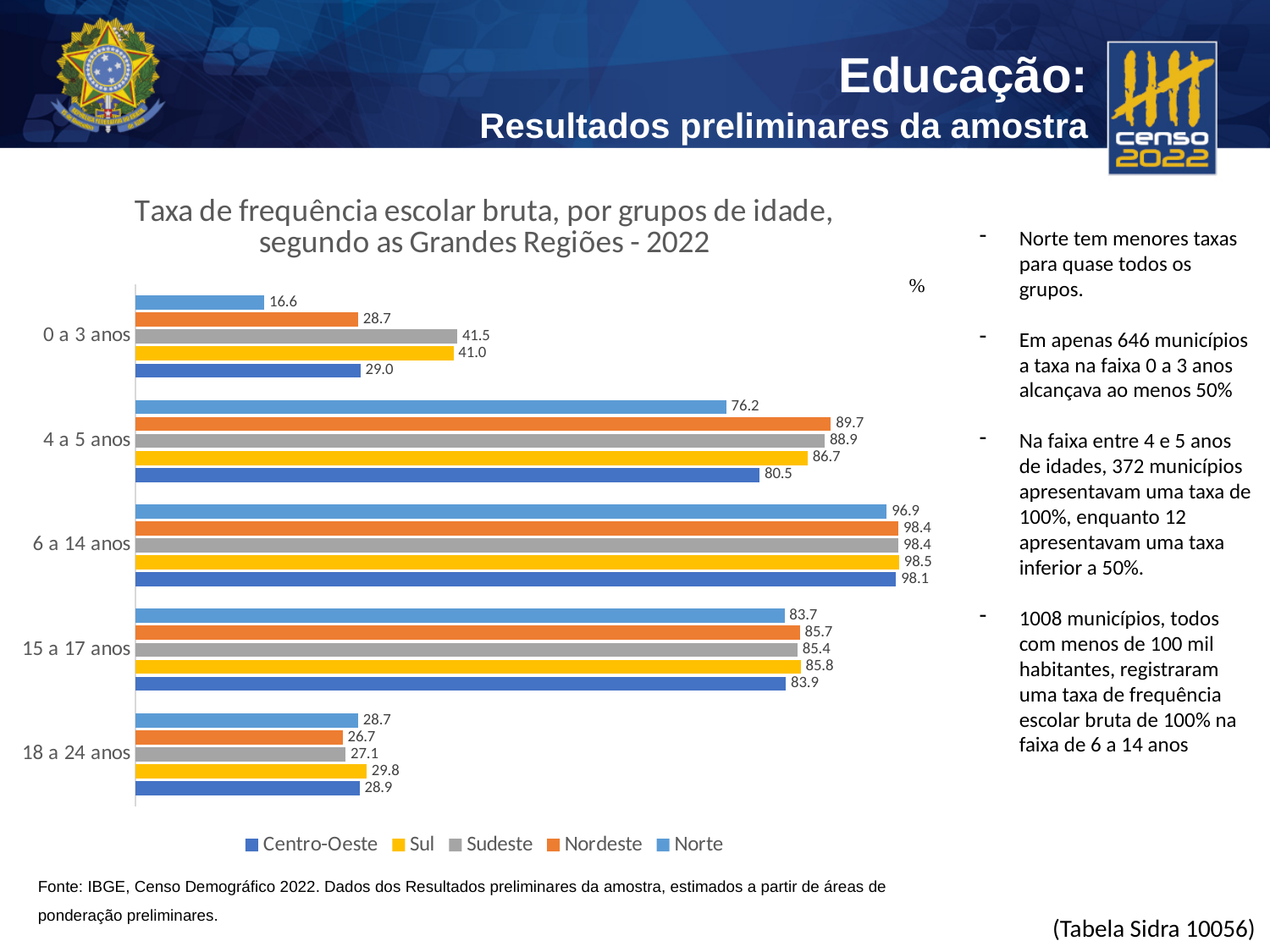
What is the difference between the Sudeste and Norte values in the 0 a 3 anos age group? 24.9 How many age groups are shown on the chart? 5 What is the difference between the Nordeste and Norte values in the 4 a 5 anos age group? 13.5 What kind of chart is shown on the slide? Bar chart What is the value for Sul in the 4 a 5 anos age group? 86.7 What is the value for Norte in the 0 a 3 anos age group? 16.6 Which region has the lowest value in the 4 a 5 anos age group? Norte How many series does the legend list? 5 In the 18 a 24 anos age group, which is larger: the value for Sul or the value for Nordeste? Sul What is the value for Centro-Oeste in the 18 a 24 anos age group? 28.9 Which colour represents Sul in the legend? Yellow Which region has the highest value in the 0 a 3 anos age group? Sudeste